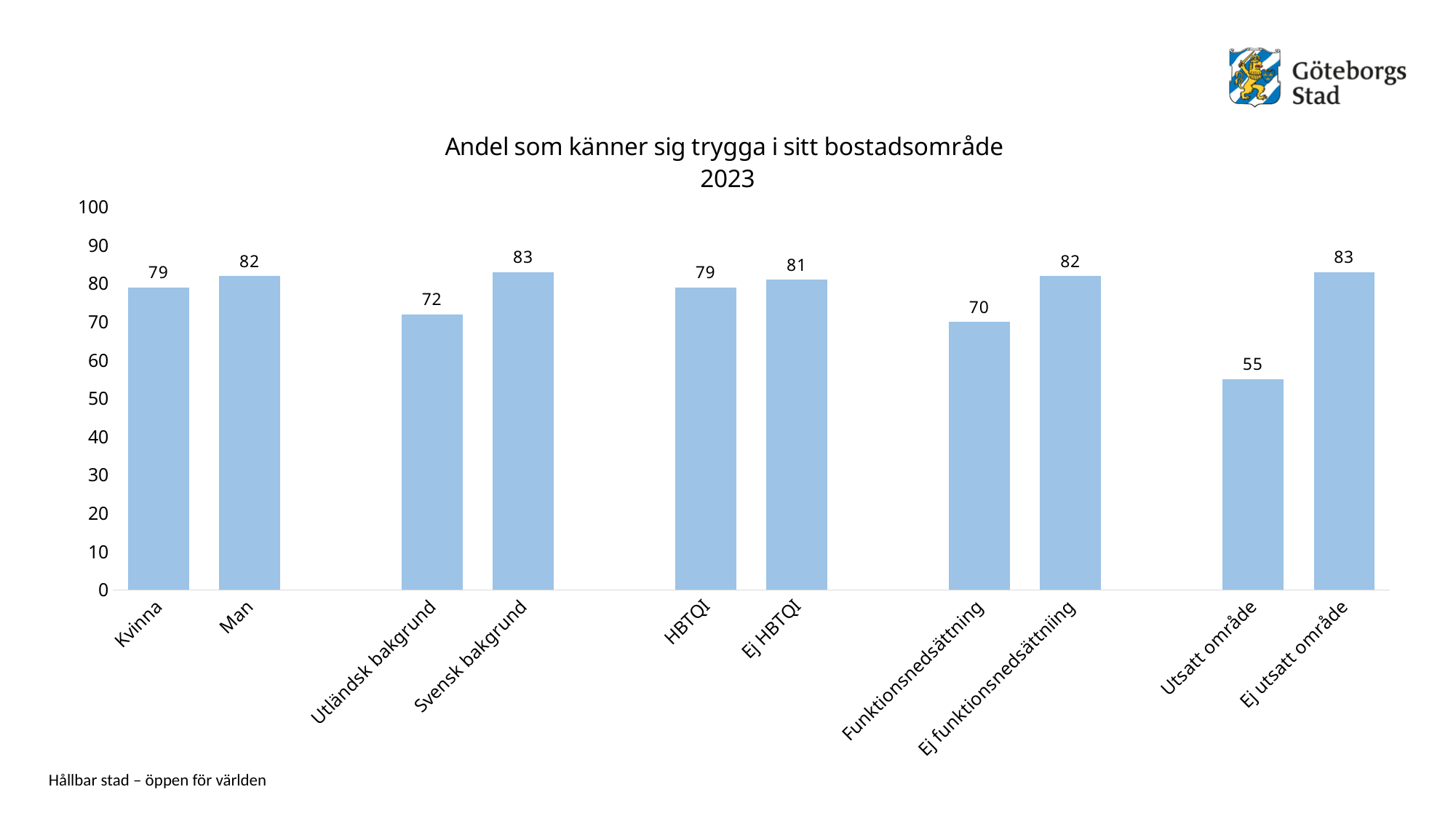
What is the value for Funktionsnedsättning? 70 What is the title of the chart? Andel som känner sig trygga i sitt bostadsområde 2023 Which is larger, the value for Man or the value for Kvinna? Man What is the value for Kvinna? 79 What is the value for Ej HBTQI? 81 What is the difference between the values for Svensk bakgrund and Utländsk bakgrund? 11 What is the value for Utsatt område? 55 What is the difference between the values for Ej utsatt område and Utsatt område? 28 What kind of chart is shown on the slide? bar chart How many categories are shown in the chart? 10 Is the value for Funktionsnedsättning greater or less than 80? less Which category has the lowest value? Utsatt område